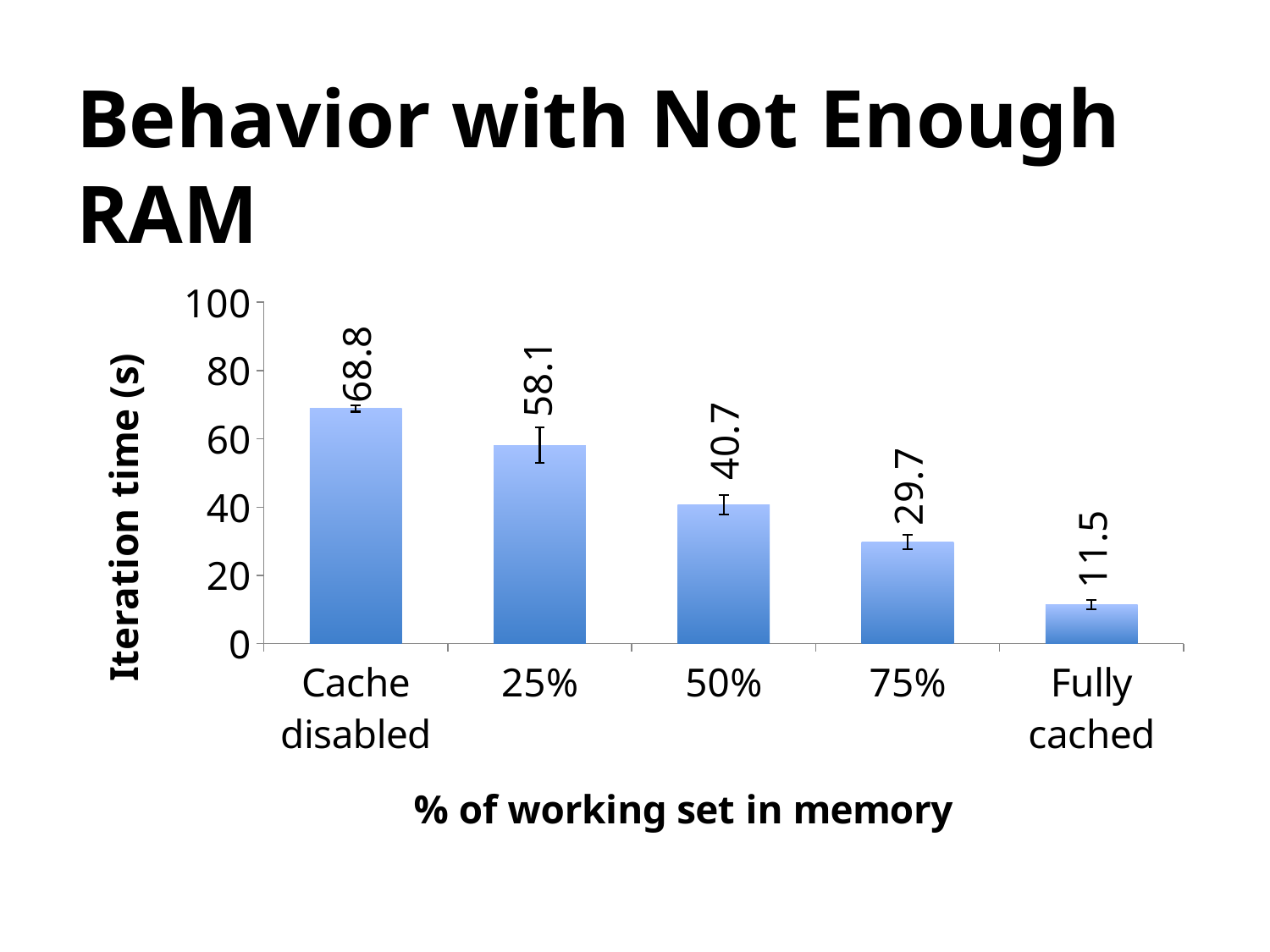
What is the difference in iteration time between Cache disabled and Fully cached? 57.3 What is the iteration time when the cache is disabled? 68.8 Do the iteration times rise or fall moving from left to right along the x axis? Fall What is the difference in iteration time between the 25% and 75% categories? 28.4 Is the iteration time for 25% greater or less than 40? greater How many categories are shown on the x axis? 5 What is the iteration time for the 50% category? 40.7 What kind of chart is shown on the slide? Bar chart Which has a larger iteration time, 50% or 75%? 50% What is the iteration time for the Fully cached category? 11.5 Which category has the highest iteration time? Cache disabled Which category has the lowest iteration time? Fully cached